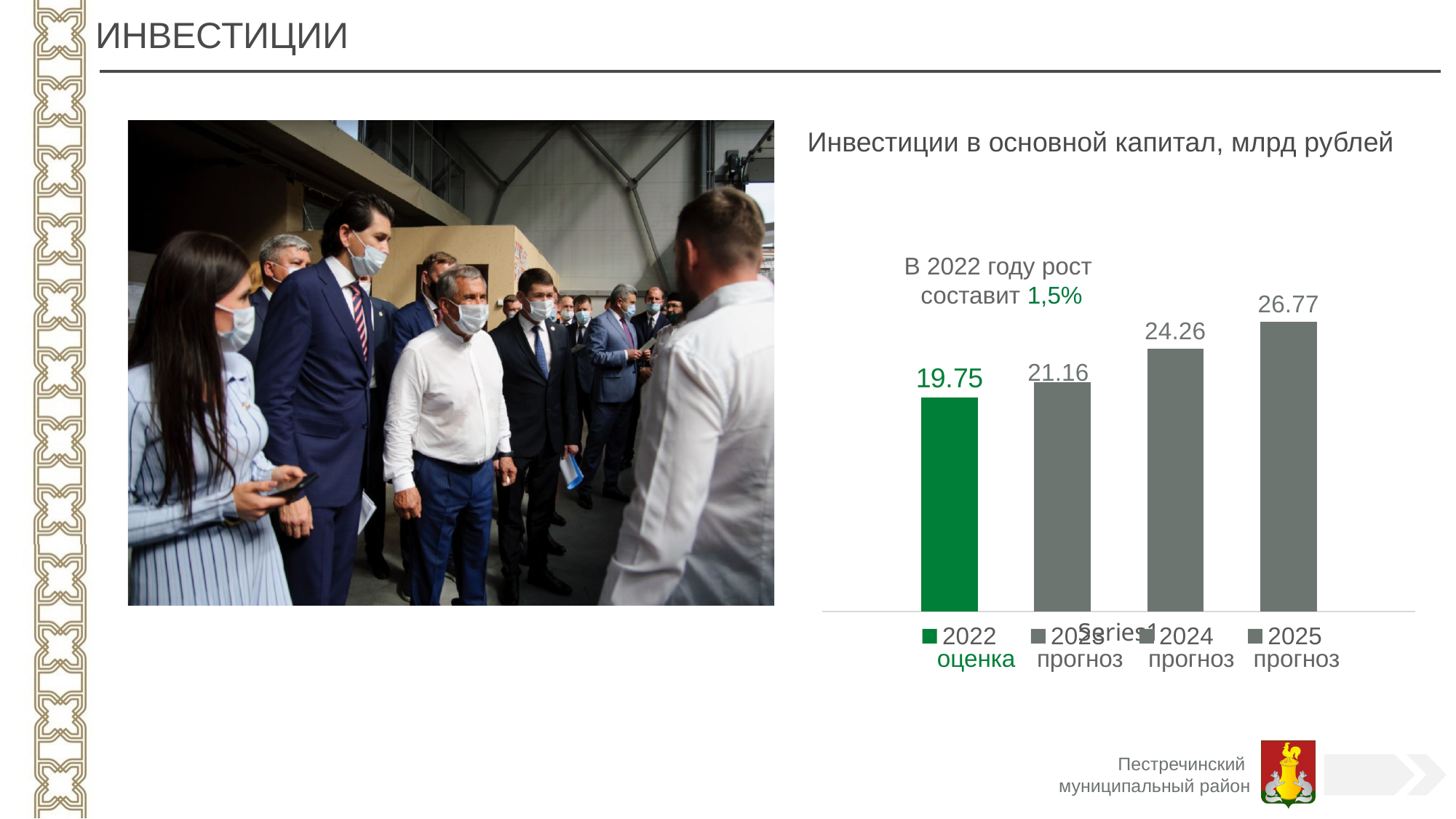
How many bars are shown in the chart? 4 What kind of chart is shown on the slide? Bar chart What is the value for 2024 (прогноз) in the chart? 24.26 What is the value for 2023 (прогноз) in the chart? 21.16 What is the difference between the values for 2025 and 2022? 7.02 Which year has the highest value in the chart? 2025 Do the values rise or fall from 2022 to 2025? Rise What is the value for 2025 (прогноз) in the chart? 26.77 Which is larger, the value for 2023 or the value for 2024? 2024 Which year has the lowest value in the chart? 2022 What is the value for 2022 (оценка) in the chart? 19.75 What is the difference between the values for 2024 and 2023? 3.1